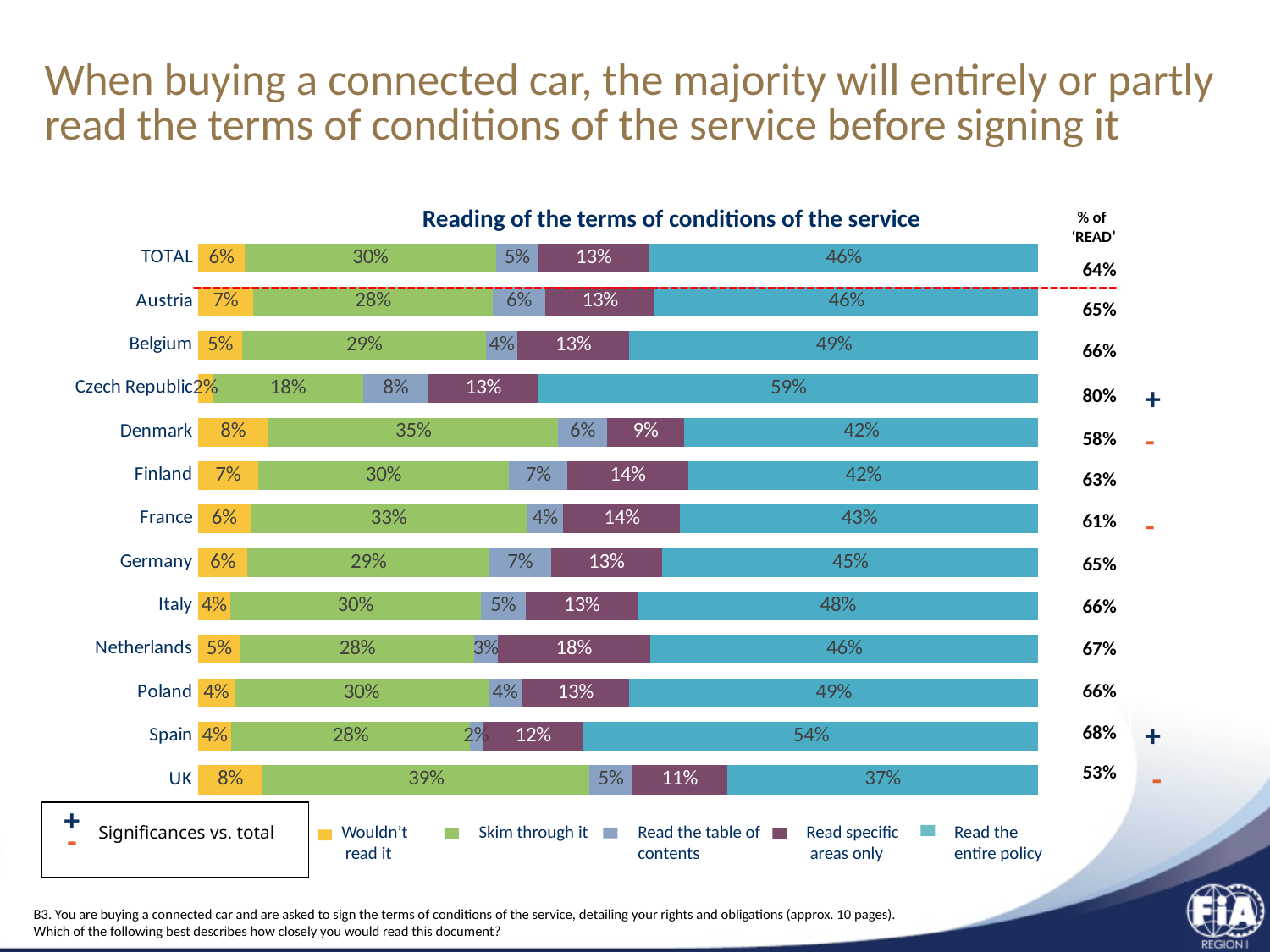
What is the 'Skim through it' value for the UK? 39% What type of chart is shown on the slide? Stacked bar chart Which has a larger 'Skim through it' value, Denmark or Finland? Denmark What is the total of the stacked bar for TOTAL (6% + 30% + 5% + 13% + 46%)? 100% What percentage of respondents in the Czech Republic would read the entire policy? 59% How many series does the legend list? 5 Which category has the highest 'Read the entire policy' value? Czech Republic What is the 'Read specific areas only' value for the Netherlands? 18% What is the title of the chart? Reading of the terms of conditions of the service How many categories (rows) are plotted in the chart, including TOTAL? 13 Which category has the lowest 'Read the entire policy' value? UK What is the difference in percentage points between the 'Read the entire policy' values for the Czech Republic and the UK? 22 percentage points